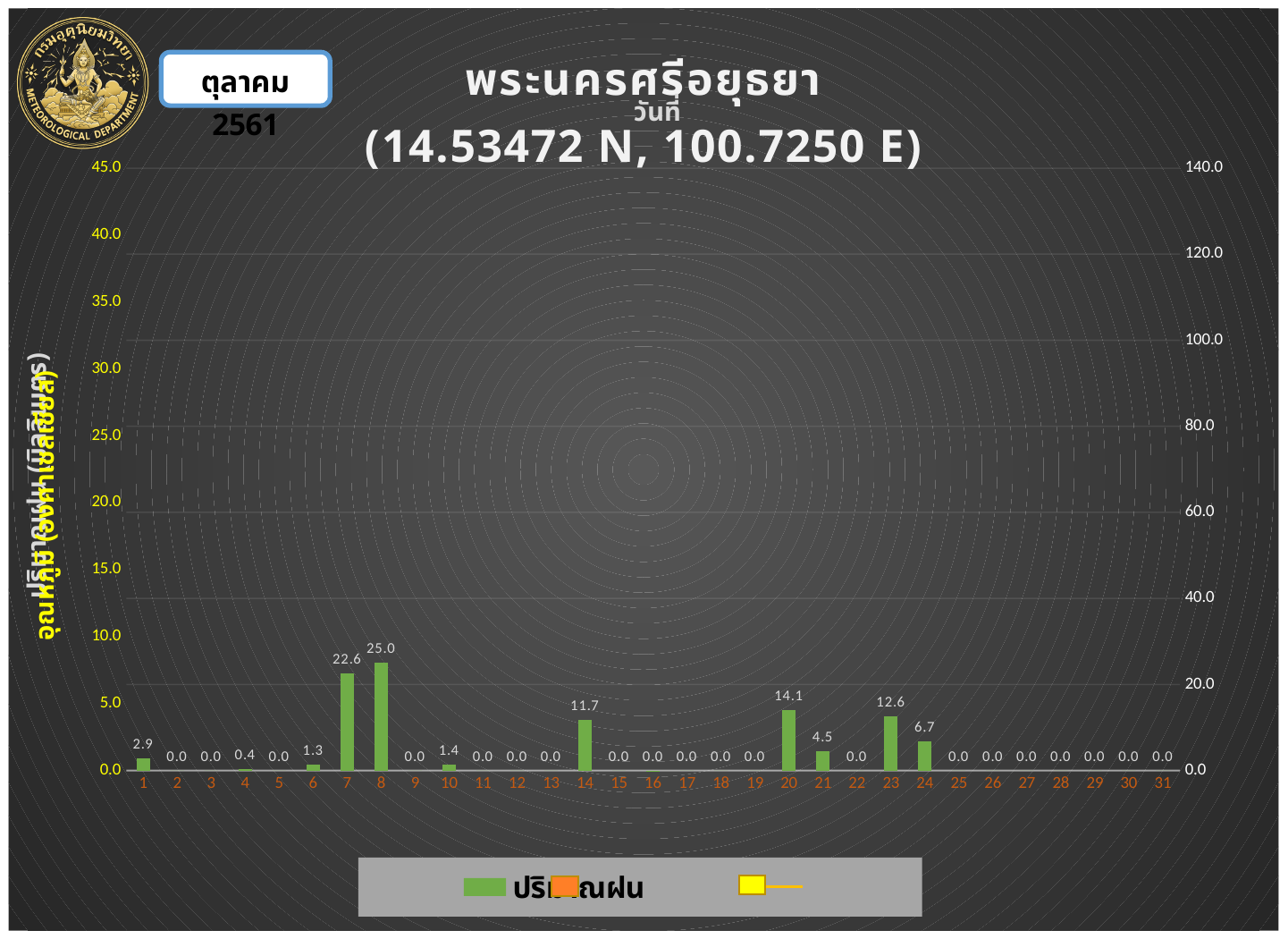
What is the rainfall value shown for day 7? 22.6 How many days are shown on the x axis? 31 What is the rainfall value shown for day 8? 25.0 Which day has the larger rainfall value, day 14 or day 20? 20 What coordinates are given in the chart title? 14.53472 N, 100.7250 E Which day has the highest rainfall value? 8 What is the rainfall value shown for day 24? 6.7 What is the difference between the rainfall values for day 8 and day 7? 2.4 What is the difference between the rainfall values for day 20 and day 23? 1.5 What is the rainfall value shown for day 14? 11.7 What kind of chart is shown on the slide? bar chart What is the rainfall value shown for day 23? 12.6